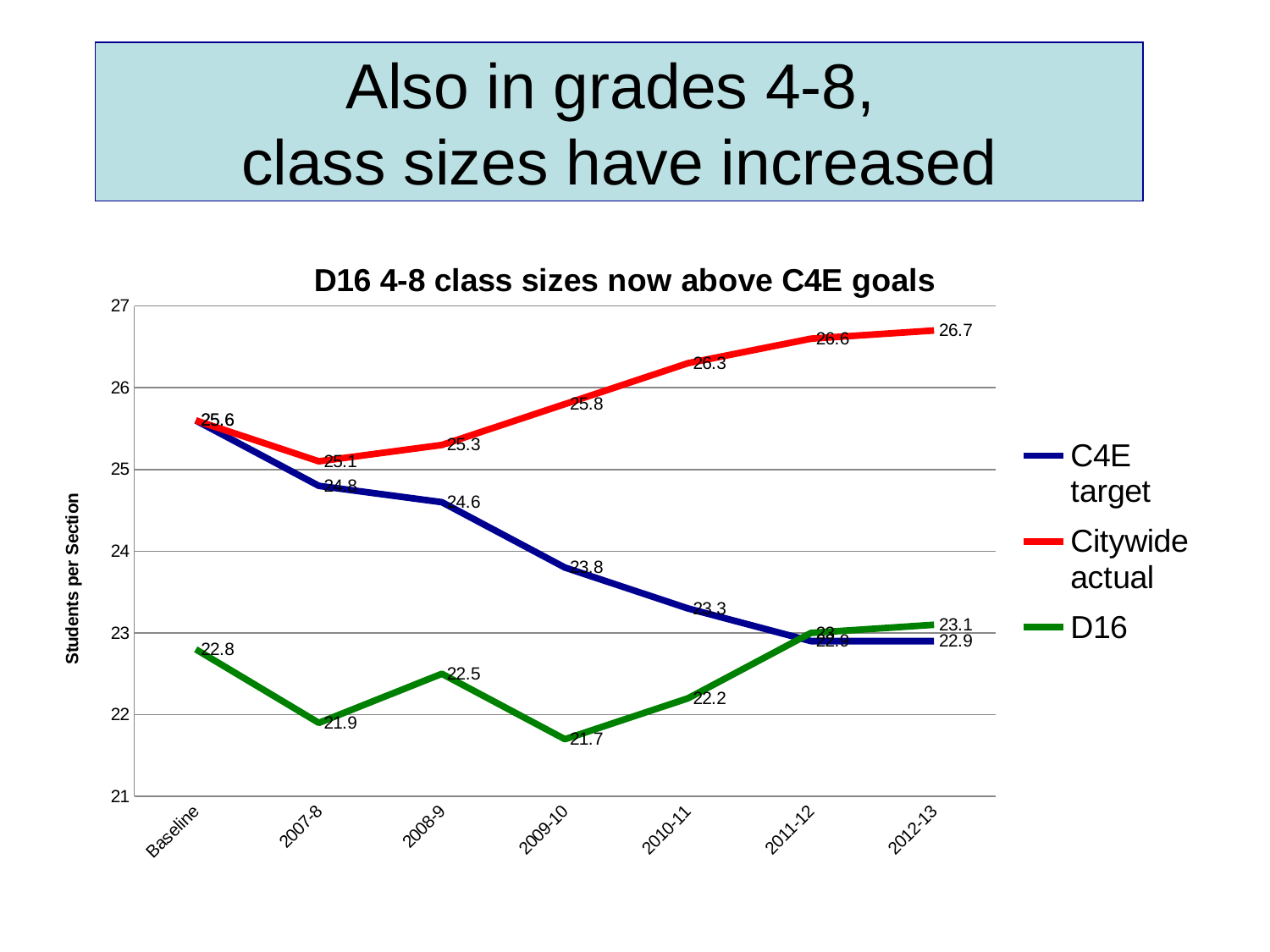
What is the difference between the Citywide actual value and the C4E target value in 2012-13? 3.8 What is the Citywide actual value for 2012-13? 26.7 How many time points are plotted on the x axis? 7 How many series does the legend list? 3 What is the D16 value for 2009-10? 21.7 Does the C4E target series rise or fall from Baseline to 2012-13? fall What is the C4E target value for 2010-11? 23.3 Is the D16 value for 2007-8 greater or less than 22? less What kind of chart is shown on the slide? line chart In 2008-9, which is larger: the C4E target or the Citywide actual? Citywide actual In which year is the D16 value lowest? 2009-10 In which year is the Citywide actual value highest? 2012-13